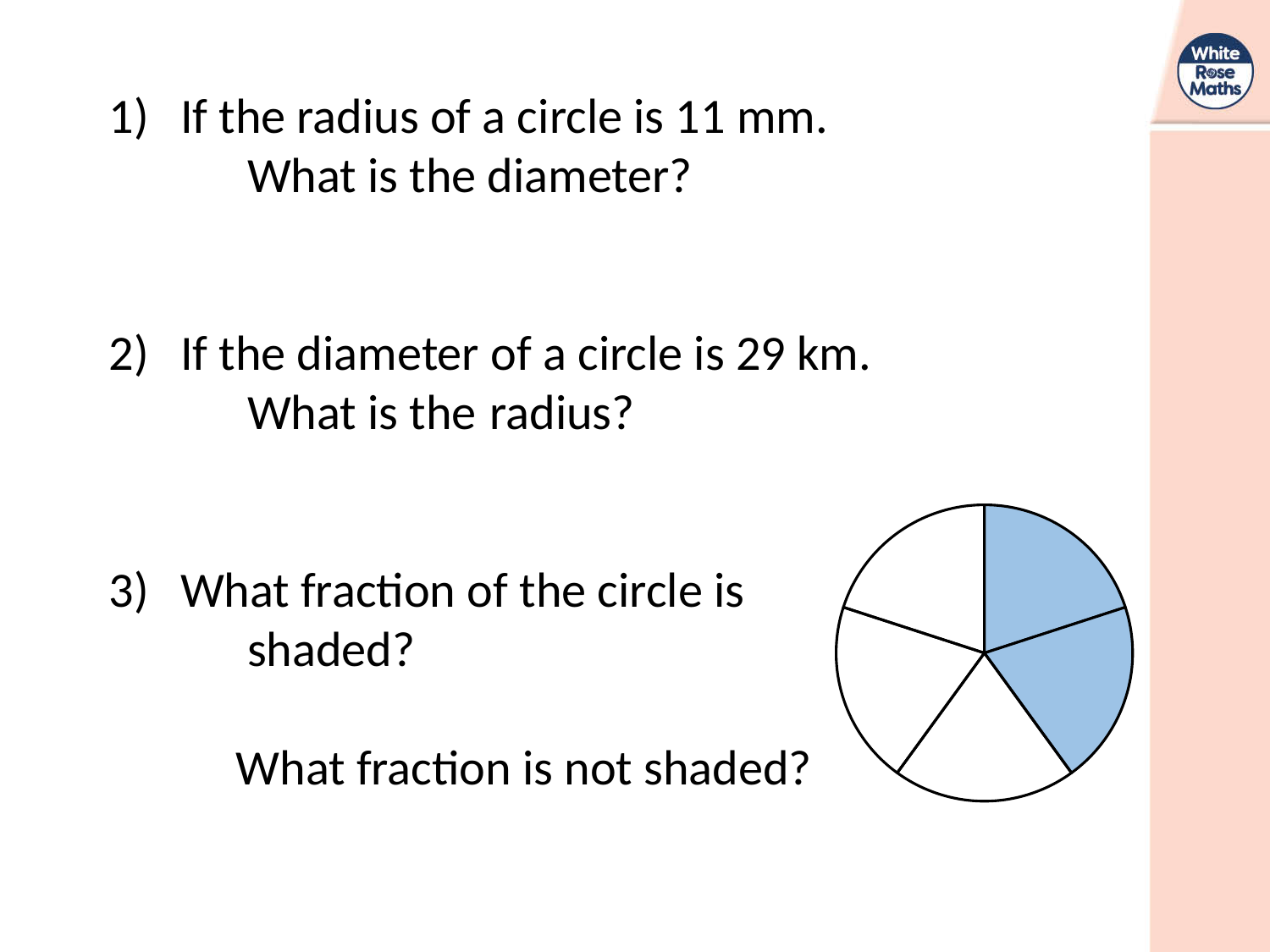
How many sectors of the circle are shaded? 2 How many equal sectors is the circle on the slide divided into? 5 What fraction of the circle is not shaded? 3/5 Are more sectors of the circle shaded or unshaded? unshaded What colour are the shaded sectors of the circle? blue What kind of chart is the circle diagram on the slide? pie chart What fraction of the circle is shaded? 2/5